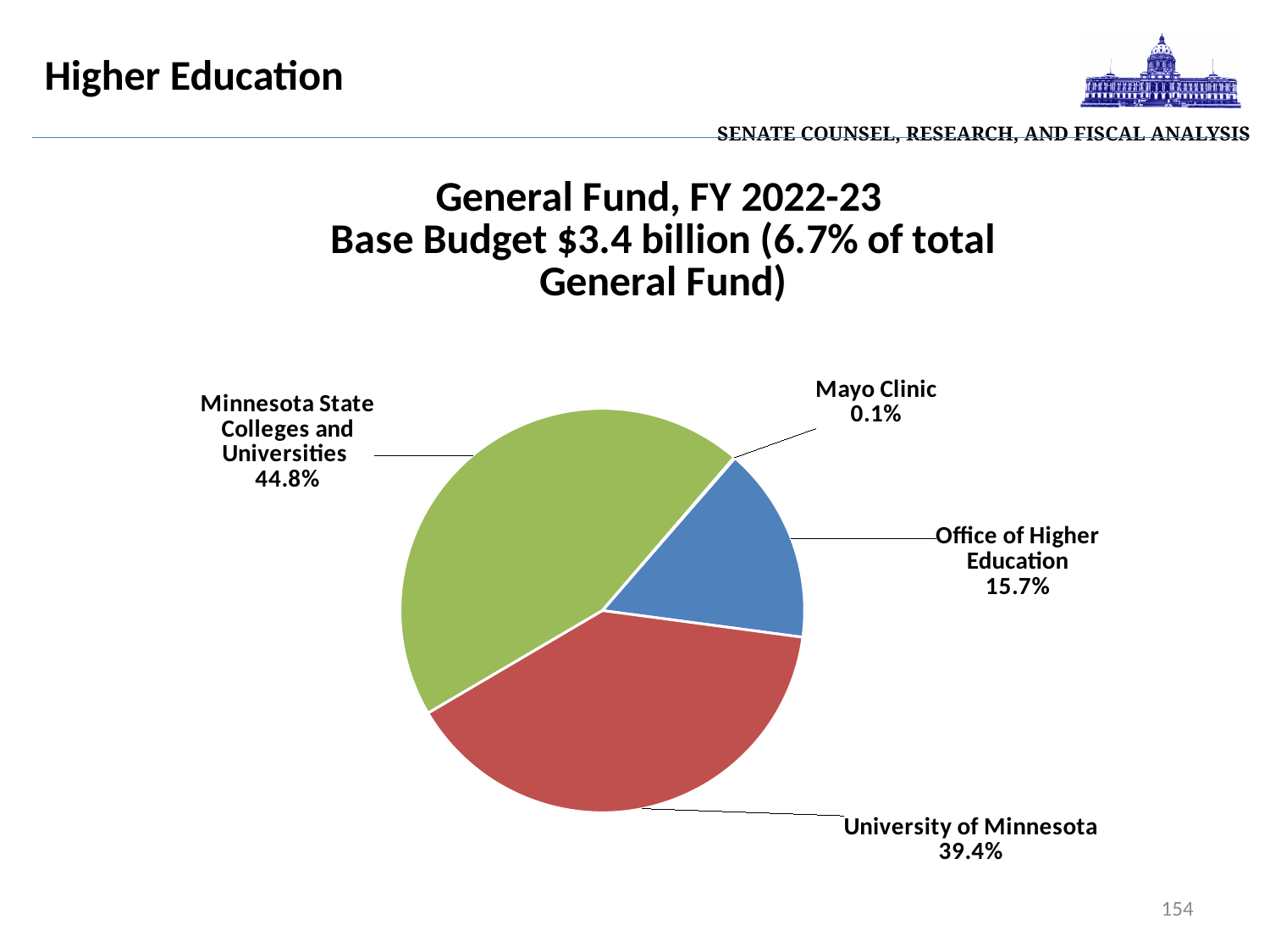
What share of the Higher Education General Fund base budget goes to Minnesota State Colleges and Universities? 44.8% What colour is the slice for the University of Minnesota? Red Which category has the largest slice of the pie? Minnesota State Colleges and Universities What is the total base budget stated in the chart title? $3.4 billion What share of the pie is labelled for the University of Minnesota? 39.4% Which category has the smallest slice of the pie? Mayo Clinic What kind of chart is shown on the slide? Pie chart How many categories are shown in the pie chart? 4 What percentage is shown for Mayo Clinic? 0.1% What is the difference in percentage points between Minnesota State Colleges and Universities and the University of Minnesota? 5.4 What percentage is shown for the Office of Higher Education? 15.7% Which is larger, the share for the University of Minnesota or the share for the Office of Higher Education? University of Minnesota